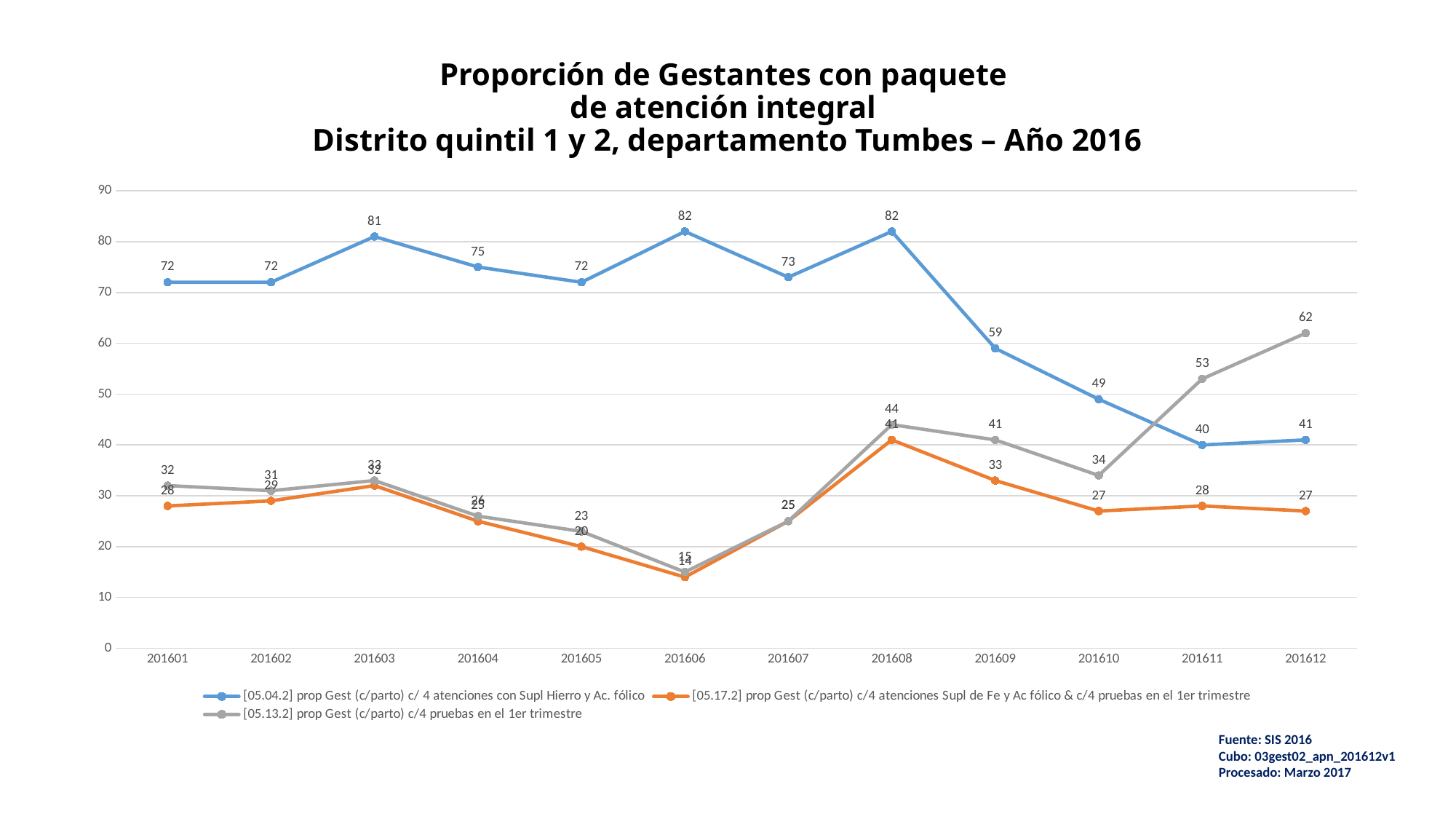
What is the value of the orange series [05.17.2] at 201608? 41 In which month does the orange series [05.17.2] reach its lowest value? 201606 What is the value of the blue series [05.04.2] at 201603? 81 What is the value of the gray series [05.13.2] at 201612? 62 In which month does the gray series [05.13.2] reach its highest value? 201612 How many months are plotted on the x axis? 12 What is the difference between the blue series [05.04.2] value at 201608 and at 201612? 41 Does the blue series [05.04.2] rise or fall from 201608 to 201611? Fall At 201611, which series has the higher value: the blue [05.04.2] or the gray [05.13.2]? Gray [05.13.2] How many series does the legend list? 3 What is the value of the blue series [05.04.2] at 201611? 40 What kind of chart is shown on the slide? Line chart